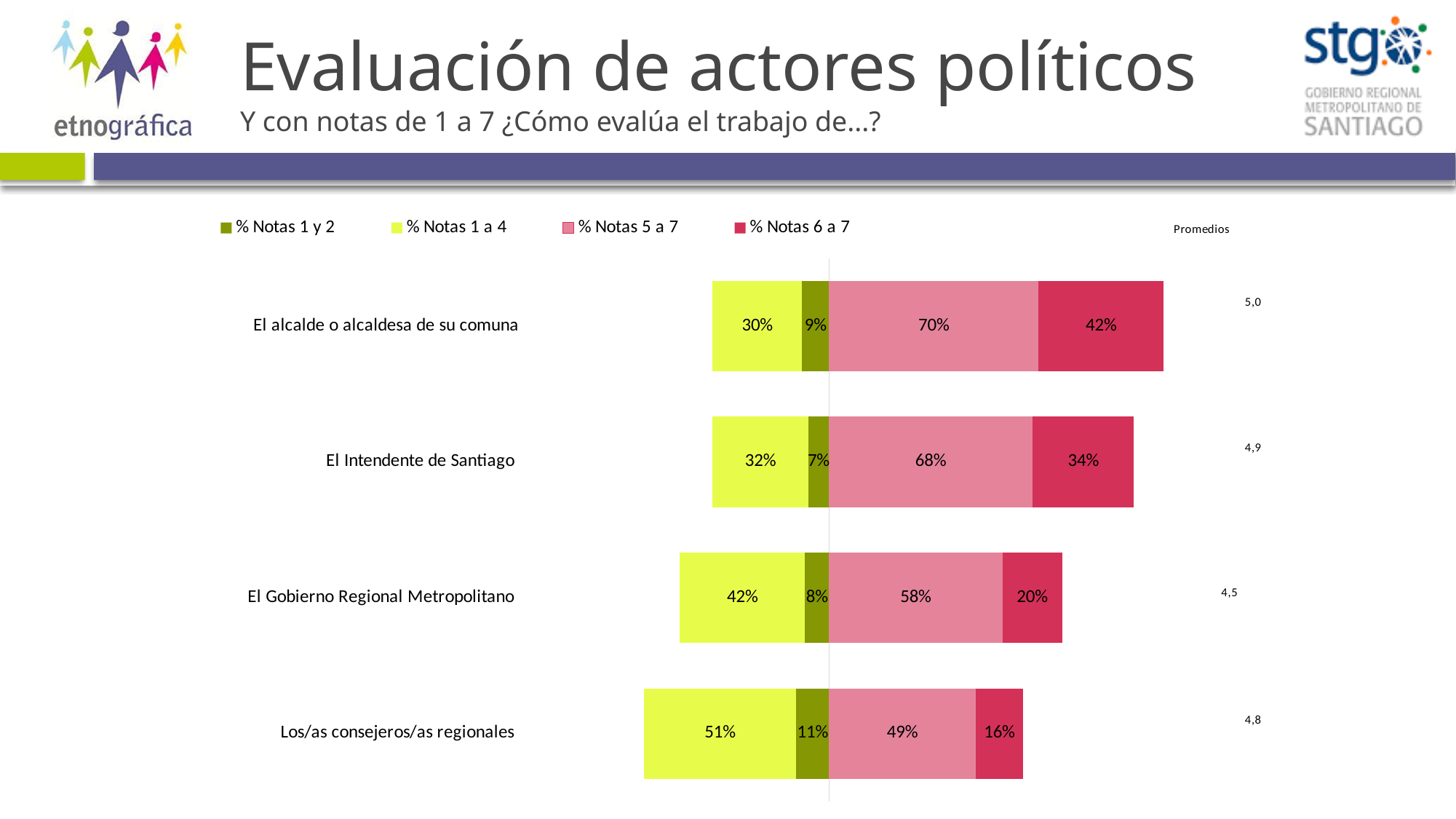
What is the 'Promedios' value shown for 'El Gobierno Regional Metropolitano'? 4,5 What percentage of respondents gave 'El alcalde o alcaldesa de su comuna' notas 6 a 7? 42% What type of chart is shown on the slide? Stacked bar chart Which political actor has the lowest '% Notas 5 a 7' value? Los/as consejeros/as regionales How many series does the chart legend list? 4 How many political actors are evaluated in the chart? 4 What is the '% Notas 1 y 2' value for 'El Intendente de Santiago'? 7% What is the '% Notas 5 a 7' value for 'El Gobierno Regional Metropolitano'? 58% What is the '% Notas 1 a 4' value for 'Los/as consejeros/as regionales'? 51% Which political actor has the highest '% Notas 6 a 7' value? El alcalde o alcaldesa de su comuna Which is larger: the '% Notas 6 a 7' value for 'El Intendente de Santiago' or for 'El Gobierno Regional Metropolitano'? El Intendente de Santiago What is the difference between the '% Notas 1 a 4' values for 'Los/as consejeros/as regionales' and 'El alcalde o alcaldesa de su comuna'? 21%